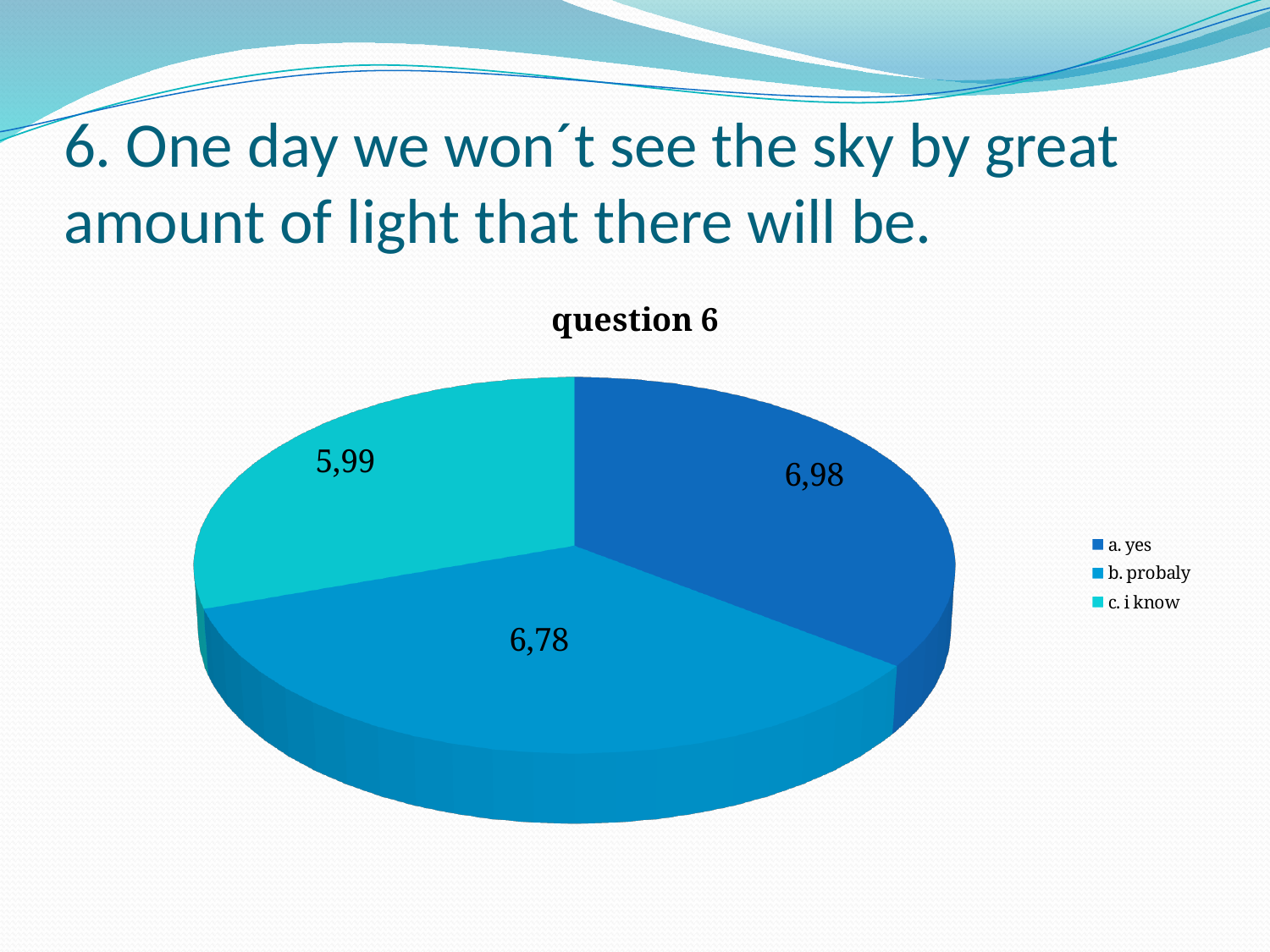
Which category has the smallest slice in the question 6 pie chart? c. i know What is the title of the chart on the slide? question 6 Which category has the largest slice in the question 6 pie chart? a. yes What is the value for "c. i know" in the question 6 pie chart? 5,99 How many slices does the question 6 pie chart have? 3 How many entries does the legend of the chart list? 3 What is the difference between the values for "b. probaly" and "c. i know"? 0,79 Which is larger, the value for "a. yes" or the value for "b. probaly"? a. yes What is the difference between the values for "a. yes" and "c. i know"? 0,99 What kind of chart is shown on the slide? Pie chart What is the value for "a. yes" in the question 6 pie chart? 6,98 What is the value for "b. probaly" in the question 6 pie chart? 6,78